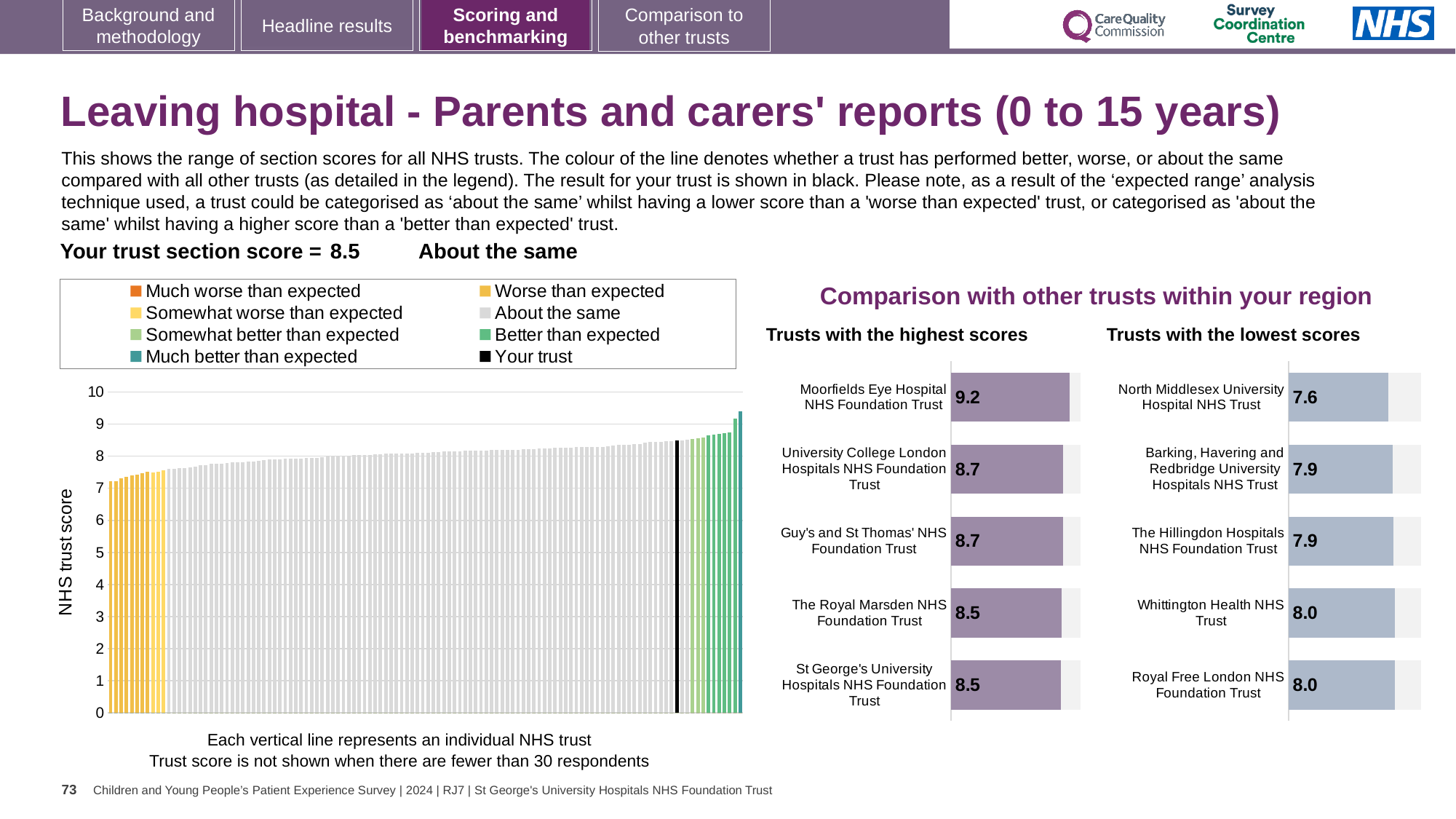
In the 'Trusts with the lowest scores' chart, what is the score for Royal Free London NHS Foundation Trust? 8.0 In the 'Trusts with the highest scores' chart, what is the score for Moorfields Eye Hospital NHS Foundation Trust? 9.2 In the NHS trust score chart on the left, do the values rise or fall from left to right? rise In the 'Trusts with the lowest scores' chart, which trust has the lowest score? North Middlesex University Hospital NHS Trust How many trusts are shown in the 'Trusts with the lowest scores' chart? 5 How many entries does the legend of the NHS trust score chart on the left list? 8 In the 'Trusts with the highest scores' chart, which trust has the highest score? Moorfields Eye Hospital NHS Foundation Trust In the 'Trusts with the highest scores' chart, what is the difference between the scores of Moorfields Eye Hospital NHS Foundation Trust and The Royal Marsden NHS Foundation Trust? 0.7 In the 'Trusts with the lowest scores' chart, which has the larger score: Whittington Health NHS Trust or North Middlesex University Hospital NHS Trust? Whittington Health NHS Trust In the 'Trusts with the lowest scores' chart, what is the score for North Middlesex University Hospital NHS Trust? 7.6 In the NHS trust score chart on the left, is the value of the tallest bar greater or less than 9? greater In the 'Trusts with the highest scores' chart, what is the score for Guy's and St Thomas' NHS Foundation Trust? 8.7